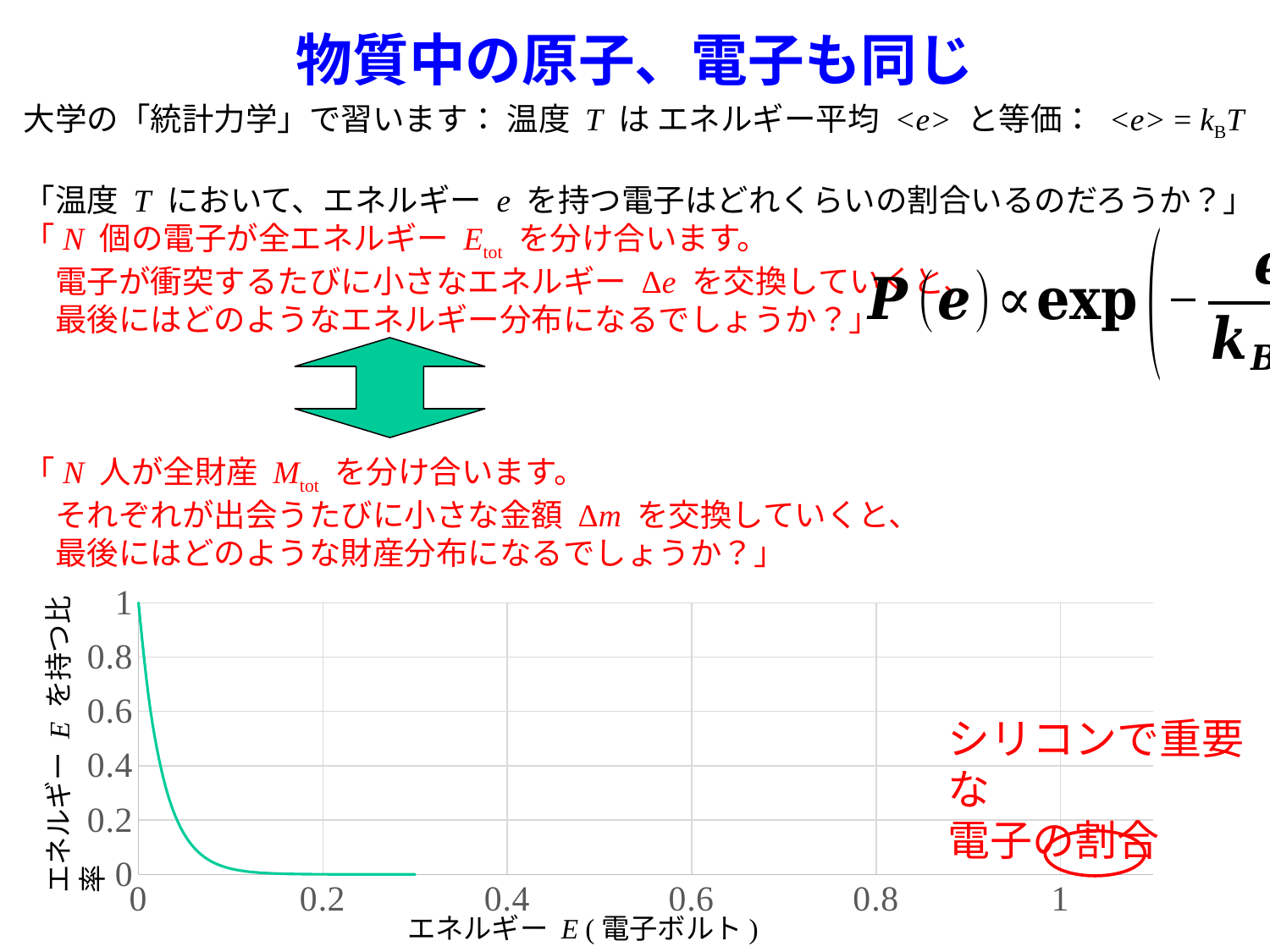
Is the value of the curve at E = 0.2 greater or less than 0.2? less How many tick labels are shown on the x axis of the chart? 6 What is the highest tick value shown on the y axis? 1 What is the value of the plotted curve at E = 0? 1 What is the label of the y axis of the chart? エネルギー E を持つ比率 Is the value of the curve at E = 0.1 greater or less than 0.4? less Which is larger, the value of the curve at E = 0 or at E = 0.2? E = 0 What is the label of the x axis of the chart? エネルギー E ( 電子ボルト ) Is the value of the curve at E = 0.05 greater or less than 0.6? less What kind of chart is shown at the bottom of the slide? line chart At what value of E does the plotted curve reach its highest value? 0 As energy E increases along the x axis, does the plotted ratio rise or fall? fall